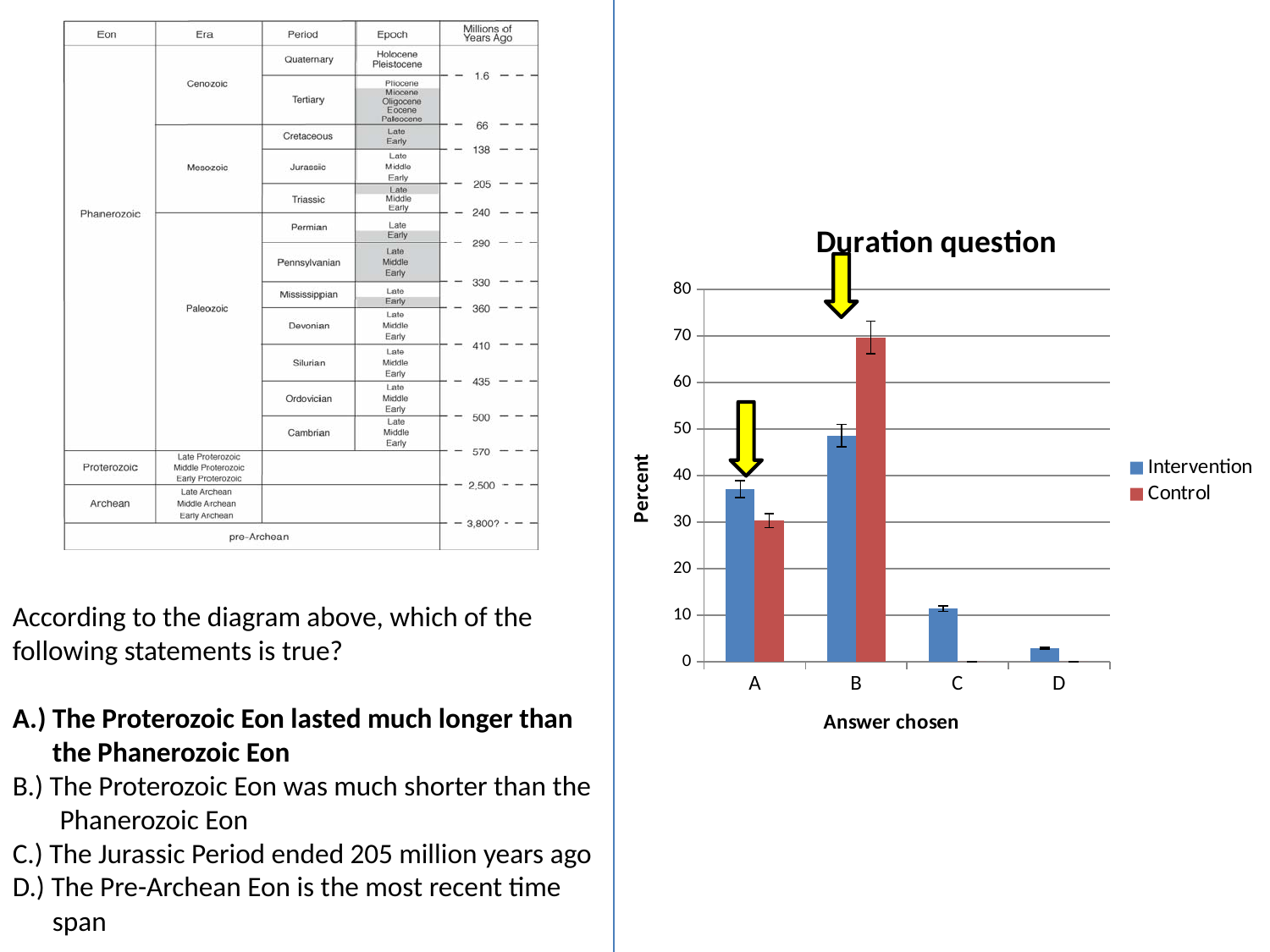
What kind of chart is shown on the slide? bar chart Is the Intervention value for answer C greater or less than 20? less For which answer chosen is the Control value highest? B How many answer categories are shown on the x axis of the chart? 4 Is the Control value for answer B greater or less than 60? greater How many series does the legend of the chart list? 2 For which answer chosen is the Intervention value lowest? D For answer A, which series has the larger value, Intervention or Control? Intervention For answer B, which series has the larger value, Intervention or Control? Control What is the label of the y axis of the chart? Percent What is the title of the chart? Duration question For which answer chosen is the Intervention value highest? B